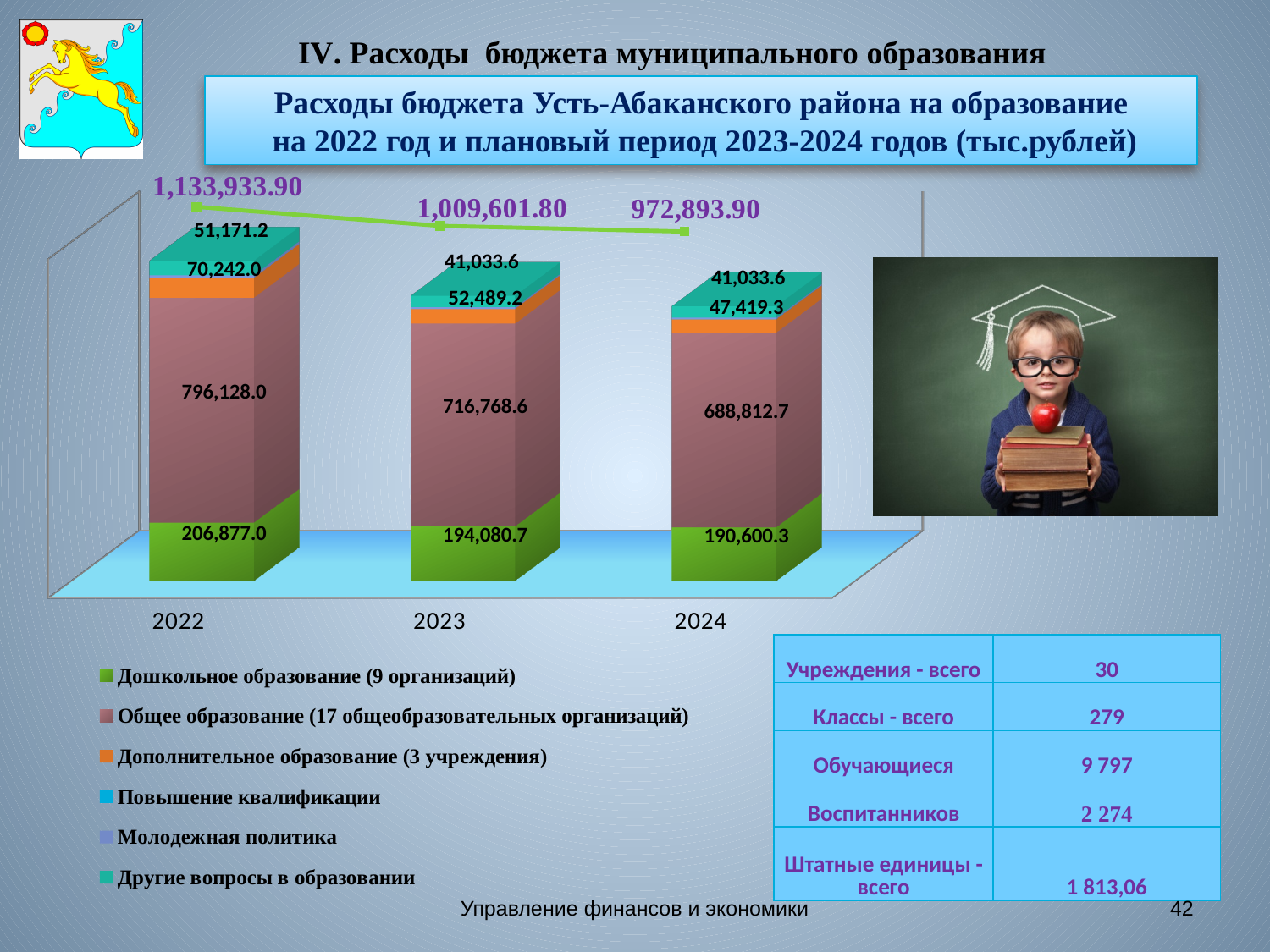
What is the total education expenditure shown for 2022? 1,133,933.90 What kind of chart is shown on the slide? Stacked bar chart What is the value for Дошкольное образование in 2024? 190,600.3 What is the total education expenditure shown for 2024? 972,893.90 What is the value for Общее образование in 2023? 716,768.6 What is the difference between the Дошкольное образование values for 2022 and 2023? 12,796.3 How many series does the chart legend list? 6 Do the total education expenditures rise or fall from 2022 to 2024? Fall Which year has the lowest value for Общее образование? 2024 How many years are shown on the x axis of the chart? 3 Is the Общее образование value larger in 2022 or in 2024? 2022 Which year has the highest total education expenditure? 2022